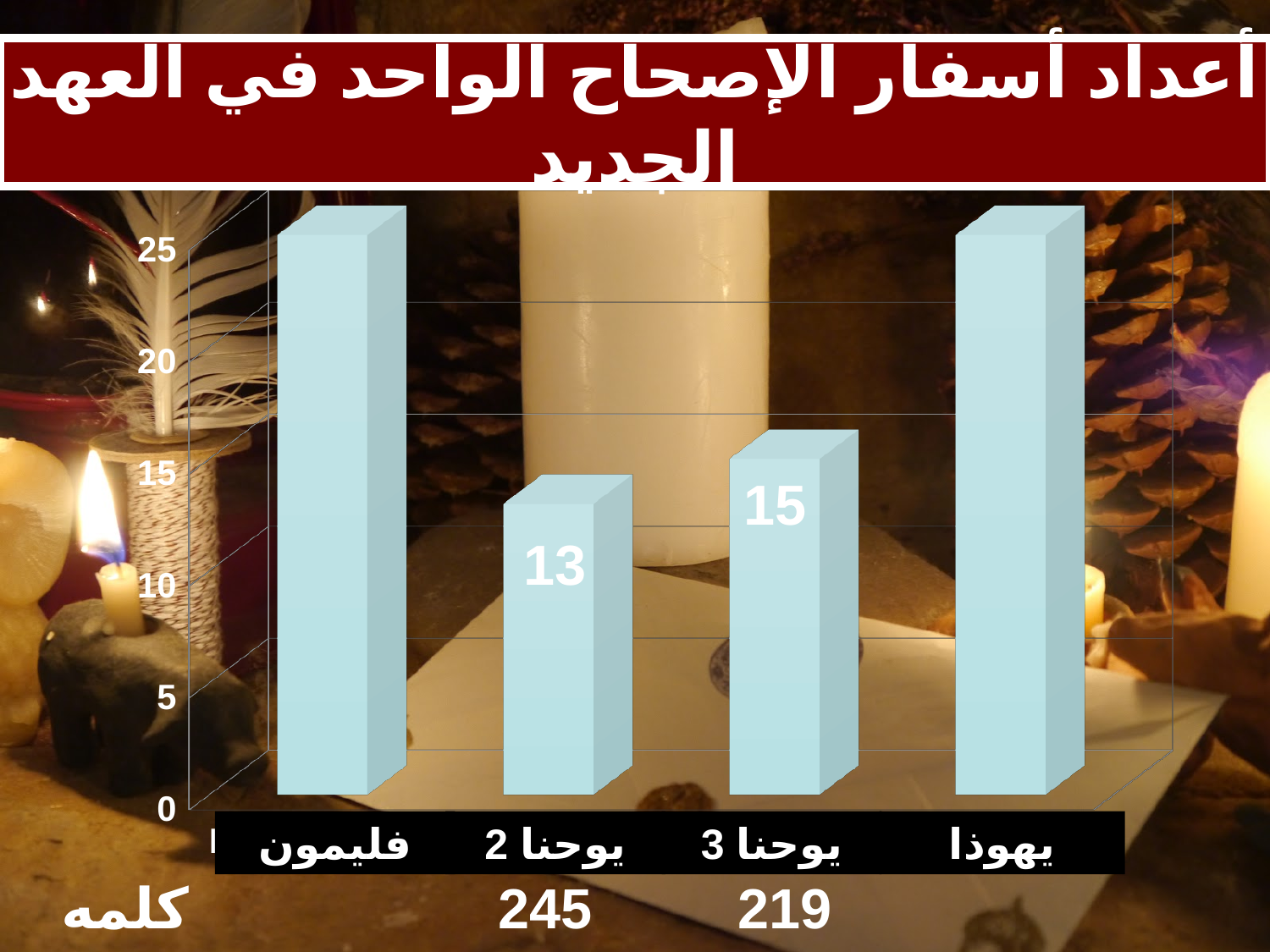
What is the value for يوحنا 3? 15 Which is larger, the value for فليمون or the value for يوحنا 2? فليمون What kind of chart is shown on the slide? bar chart Which is larger, the value for يوحنا 2 or the value for يوحنا 3? يوحنا 3 How many categories are shown on the chart? 4 Is the value for يوحنا 2 greater or less than 15? less What is the title of the slide? أعداد أسفار الإصحاح الواحد في العهد الجديد What is the value for يوحنا 2? 13 Which category has the lowest value? يوحنا 2 What is the difference between the values for يوحنا 3 and يوحنا 2? 2 Is the value for فليمون greater or less than 20? greater Is the value for يهوذا greater or less than 20? greater